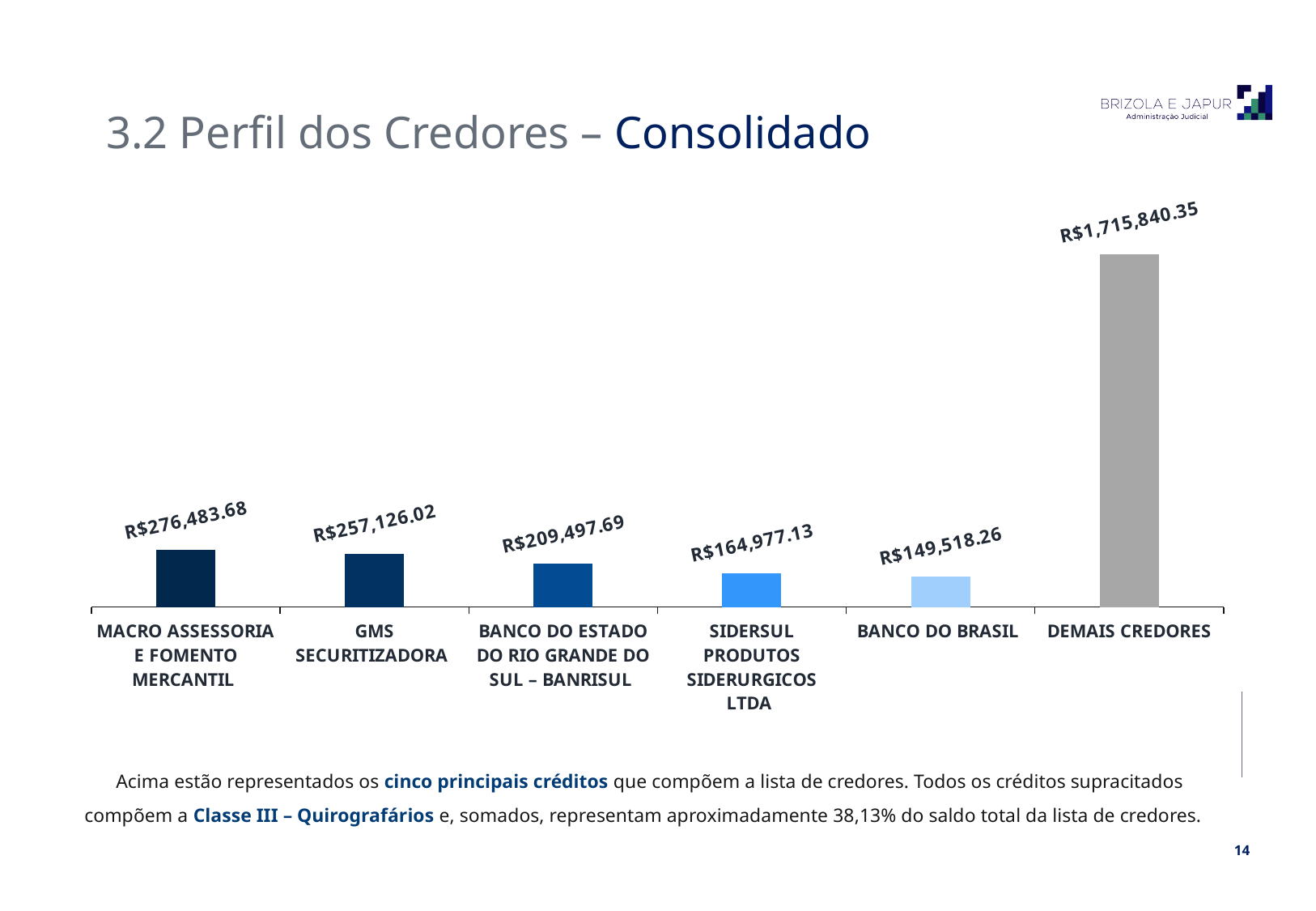
What is the value shown for SIDERSUL PRODUTOS SIDERURGICOS LTDA? R$164,977.13 What is the value shown for DEMAIS CREDORES? R$1,715,840.35 What is the difference between the values for MACRO ASSESSORIA E FOMENTO MERCANTIL and GMS SECURITIZADORA? R$19,357.66 What is the value shown for GMS SECURITIZADORA? R$257,126.02 Do the values rise or fall from MACRO ASSESSORIA E FOMENTO MERCANTIL to BANCO DO BRASIL? Fall Which category has the highest value? DEMAIS CREDORES What kind of chart is shown on the slide? Bar chart Which is larger, the value for BANCO DO ESTADO DO RIO GRANDE DO SUL – BANRISUL or the value for SIDERSUL PRODUTOS SIDERURGICOS LTDA? BANCO DO ESTADO DO RIO GRANDE DO SUL – BANRISUL How many categories are shown in the chart? 6 What is the difference between the values for SIDERSUL PRODUTOS SIDERURGICOS LTDA and BANCO DO BRASIL? R$15,458.87 What is the value shown for BANCO DO BRASIL? R$149,518.26 Which category has the lowest value? BANCO DO BRASIL